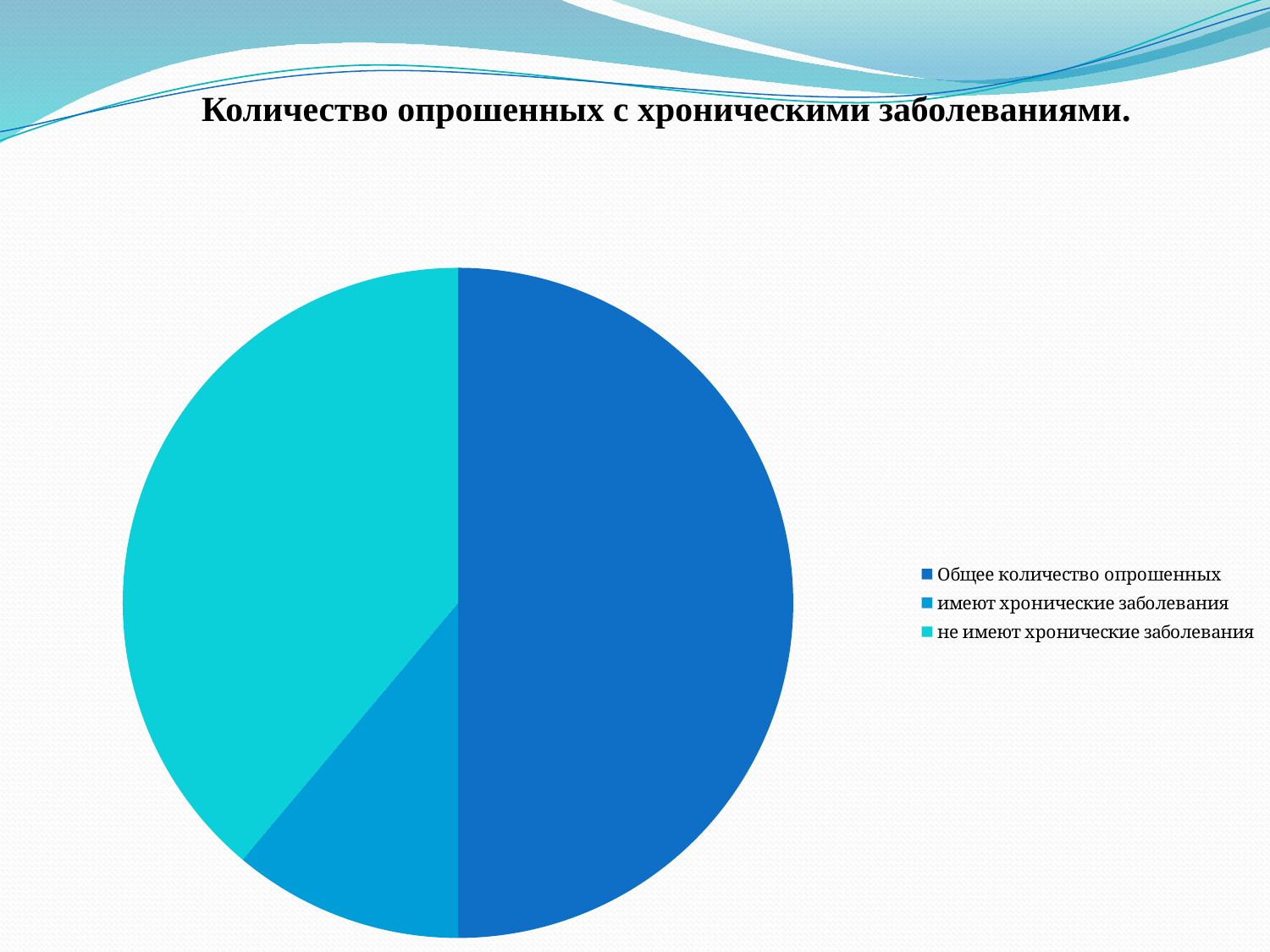
How many slices does the pie chart have? 3 Which slice is larger: "имеют хронические заболевания" or "не имеют хронические заболевания"? не имеют хронические заболевания How many entries does the legend list? 3 What kind of chart is shown on the slide? pie chart Which category has the largest slice of the pie? Общее количество опрошенных Which category has the smallest slice of the pie? имеют хронические заболевания Which legend entry is shown in the lightest (cyan) colour? не имеют хронические заболевания Which slice is larger: "Общее количество опрошенных" or "не имеют хронические заболевания"? Общее количество опрошенных What is the title of the chart? Количество опрошенных с хроническими заболеваниями.